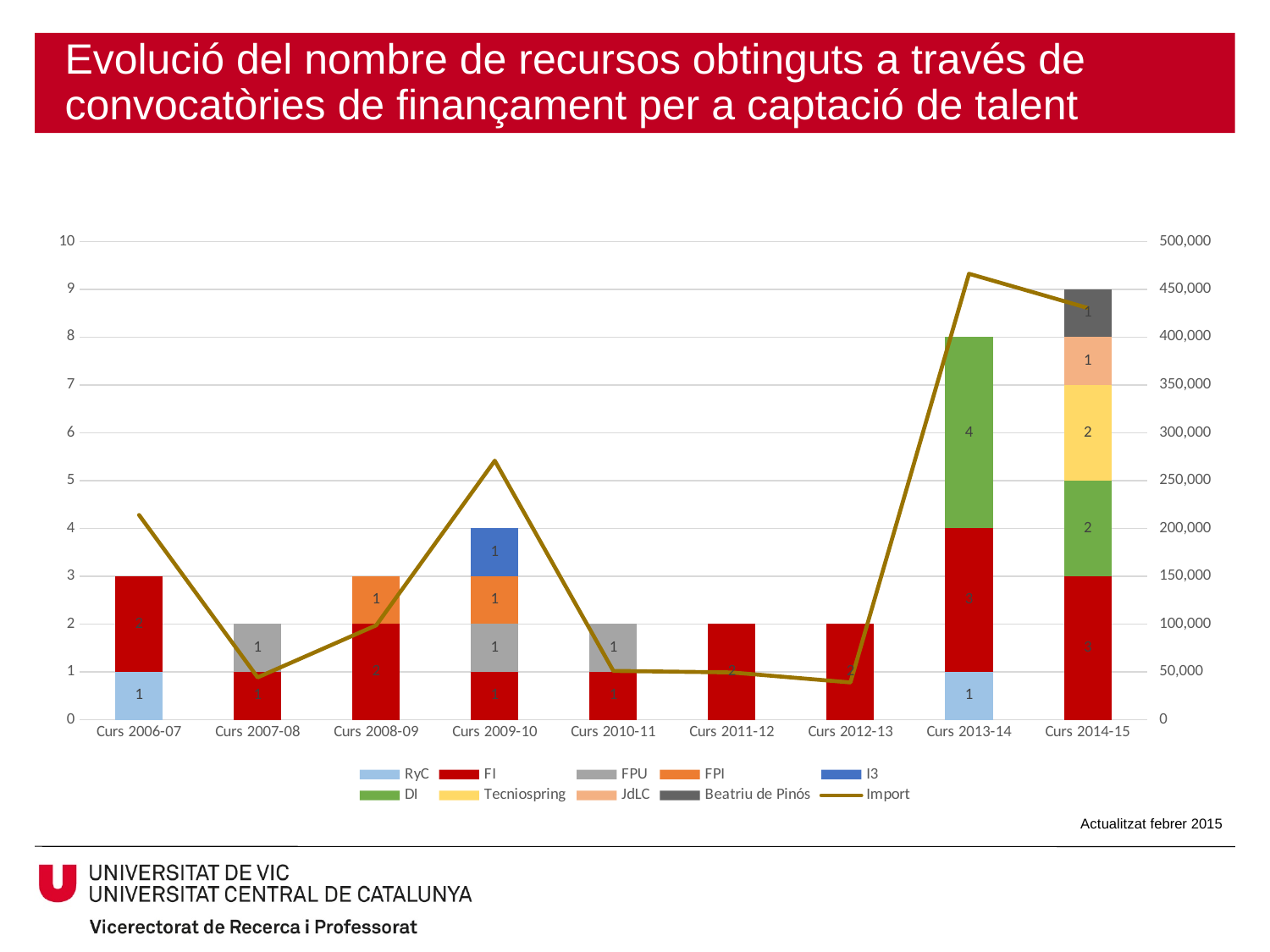
What is the value of the Tecniospring segment for Curs 2014-15? 2 Is the Import line value for Curs 2007-08 greater or less than 100,000? less What is the value of the I3 segment for Curs 2009-10? 1 What is the total height of the stacked bar for Curs 2014-15? 9 Which academic year has the highest total number of resources (tallest stacked bar)? Curs 2014-15 What is the value of the DI segment for Curs 2013-14? 4 How many academic years (Curs) are shown on the x axis? 9 How many series does the legend list? 10 What is the total height of the stacked bar for Curs 2013-14? 8 Is the Import line value for Curs 2013-14 greater or less than 400,000? greater What kind of chart is shown on the slide? A stacked bar chart with a line Which series is plotted as a line rather than as bars? Import